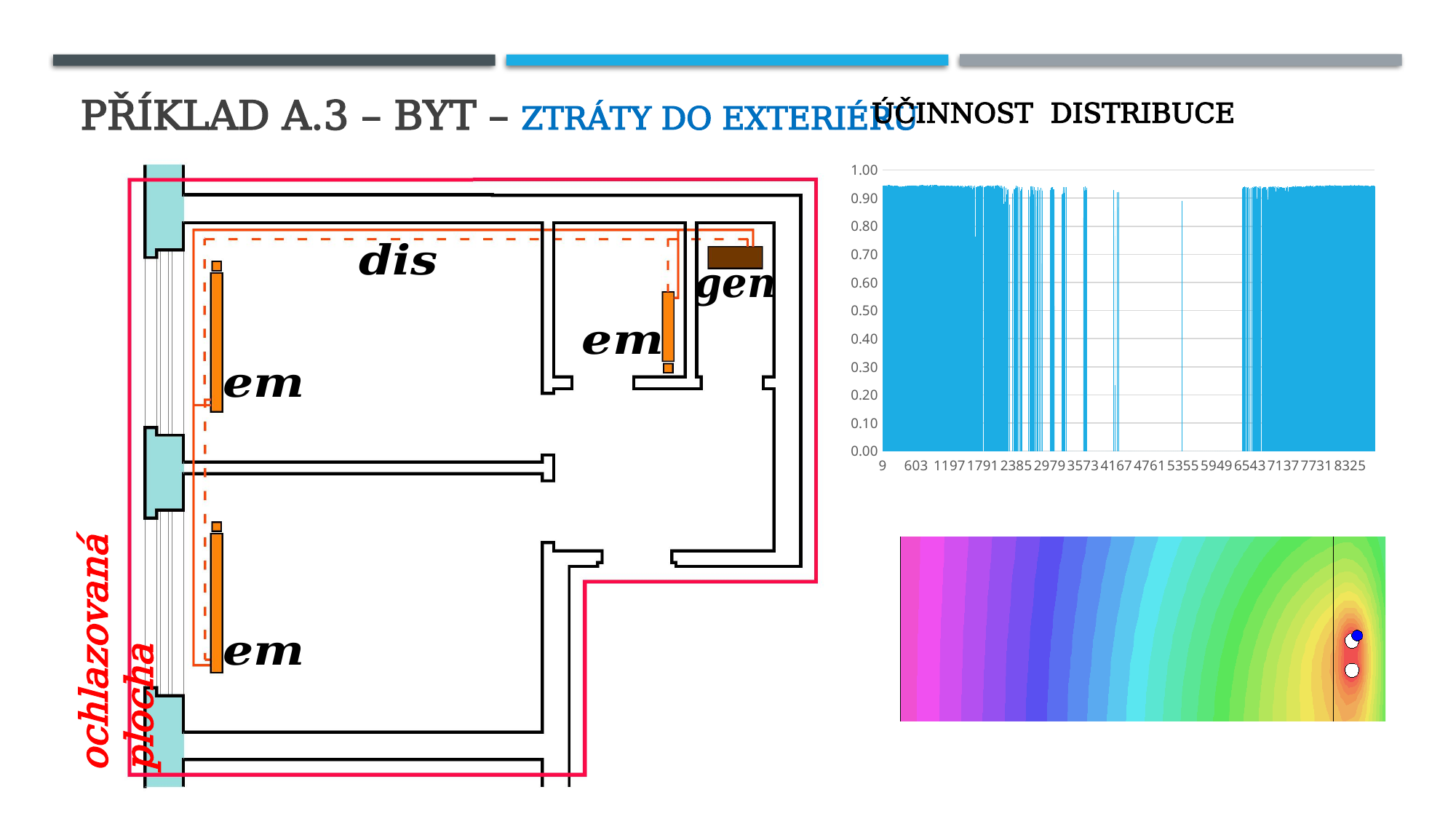
In the ÚČINNOST DISTRIBUCE chart, what colour are the bars? blue In the ÚČINNOST DISTRIBUCE chart, how many tick labels are printed along the horizontal axis? 15 In the ÚČINNOST DISTRIBUCE chart, what is the step between consecutive labels on the vertical axis? 0.10 What kind of chart is shown under the heading ÚČINNOST DISTRIBUCE? bar chart In the ÚČINNOST DISTRIBUCE chart, what is the highest value labelled on the vertical axis? 1.00 In the ÚČINNOST DISTRIBUCE chart, are the bar values near the end of the horizontal axis (around 6543 to 8325) greater or less than 0.50? greater What is the title of the chart on the right side of the slide? ÚČINNOST DISTRIBUCE In the ÚČINNOST DISTRIBUCE chart, what is the first label on the horizontal axis? 9 In the ÚČINNOST DISTRIBUCE chart, do the tallest bars reach above or below 1.00? below In the ÚČINNOST DISTRIBUCE chart, what is the last label on the horizontal axis? 8325 In the ÚČINNOST DISTRIBUCE chart, are the bar values near the start of the horizontal axis (around 9 to 1791) greater or less than 0.90? greater